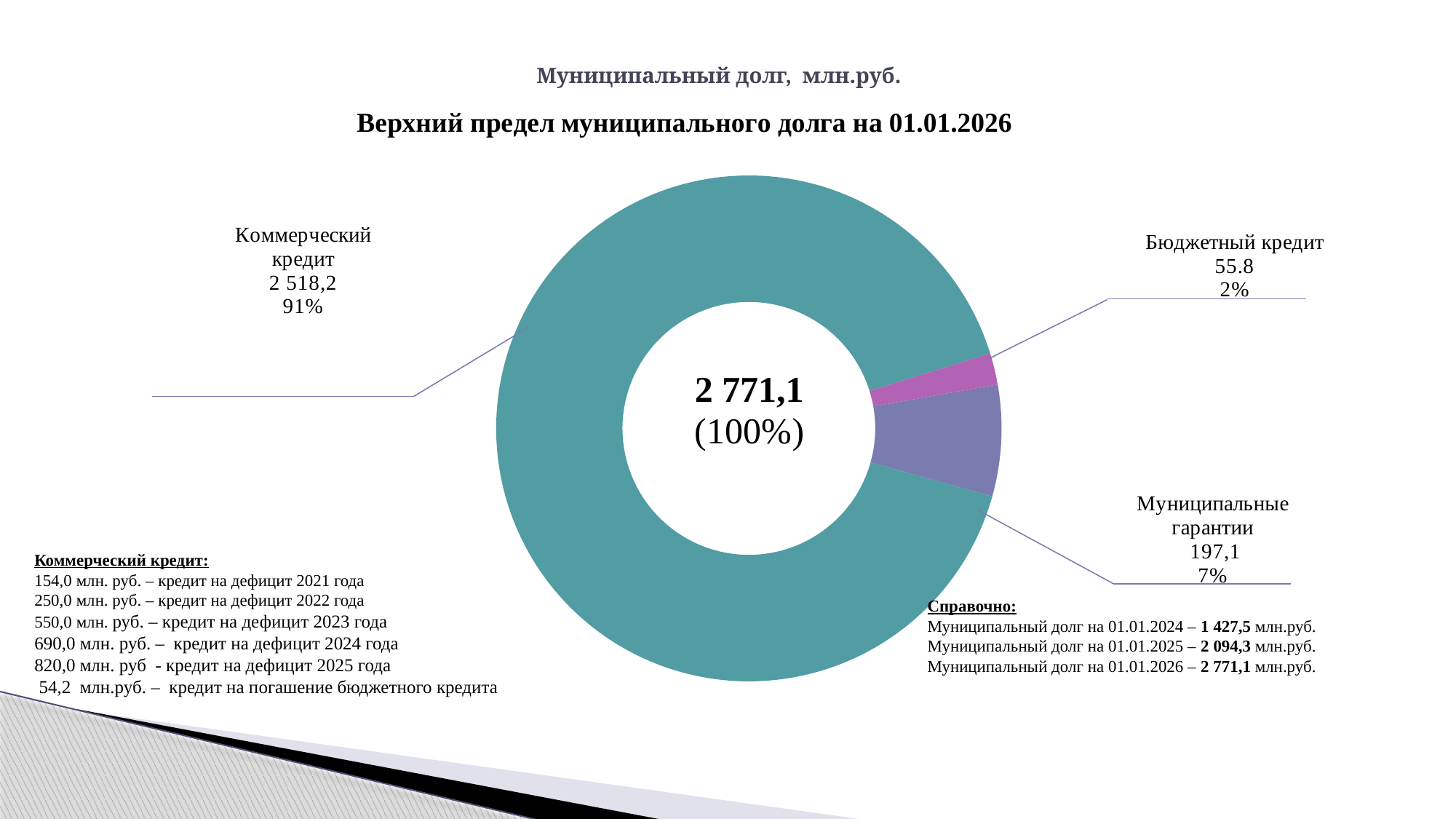
What total value is shown in the centre of the chart? 2 771,1 What kind of chart is shown on the slide? Donut (pie) chart Which category has the smallest value? Бюджетный кредит What is the value for Коммерческий кредит? 2 518,2 What is the value for Муниципальные гарантии? 197,1 What is the value for Бюджетный кредит? 55.8 Which category has the largest value? Коммерческий кредит How many categories does the chart show? 3 Which is larger, Муниципальные гарантии or Бюджетный кредит? Муниципальные гарантии What share of the total does Коммерческий кредит represent? 91% What share of the total does Муниципальные гарантии represent? 7% What share of the total does Бюджетный кредит represent? 2%